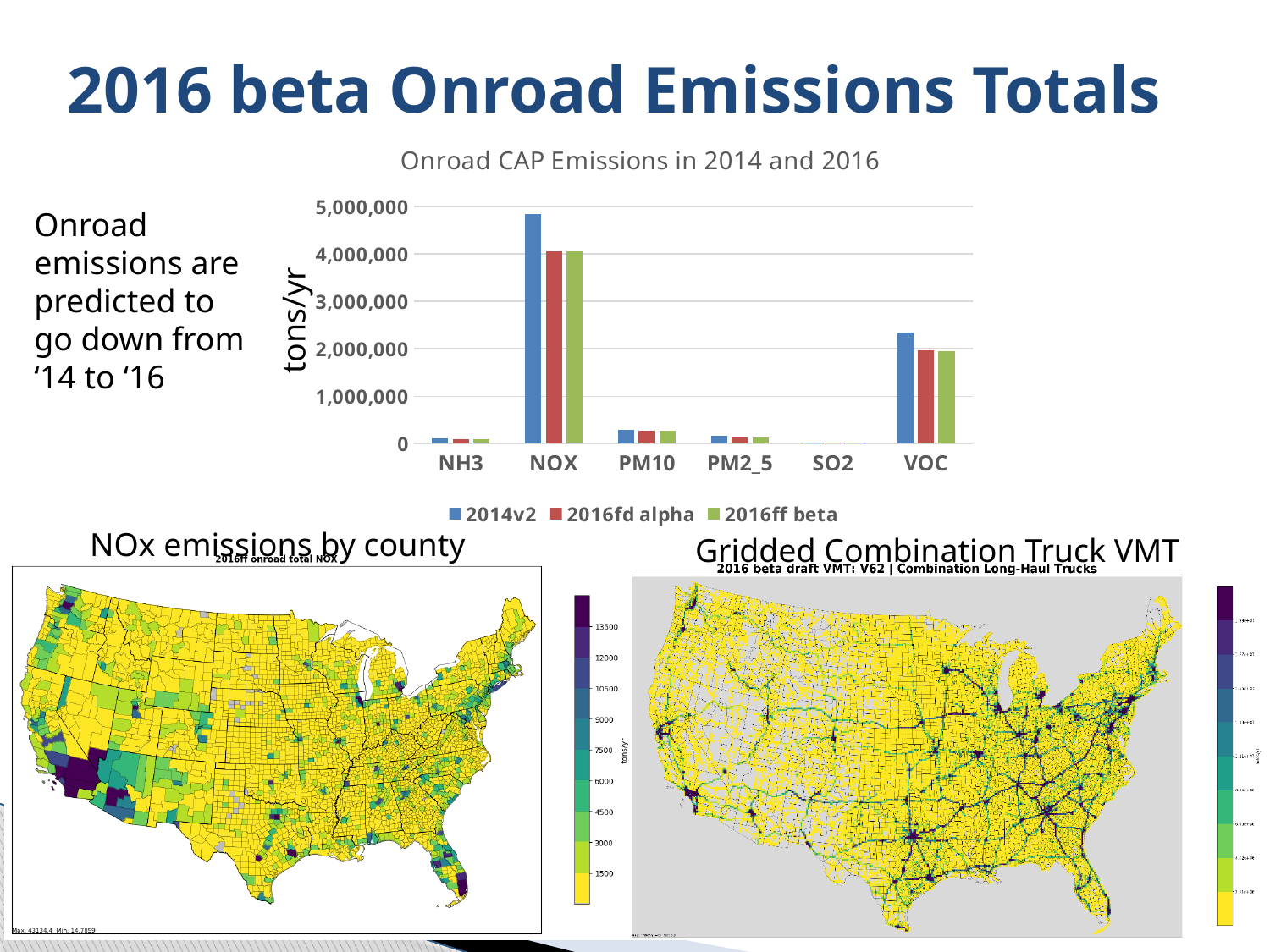
In the 'Onroad CAP Emissions in 2014 and 2016' chart, do NOX emissions rise or fall from 2014v2 to 2016ff beta? fall In the 'Onroad CAP Emissions in 2014 and 2016' chart, which pollutant has the lowest emissions? SO2 How many pollutant categories are shown on the x axis of the 'Onroad CAP Emissions in 2014 and 2016' chart? 6 In the 'Onroad CAP Emissions in 2014 and 2016' chart, is the 2014v2 value for NH3 greater or less than 1,000,000? less In the 'Onroad CAP Emissions in 2014 and 2016' chart, which is larger for NOX: the 2014v2 value or the 2016ff beta value? 2014v2 What kind of chart is 'Onroad CAP Emissions in 2014 and 2016'? bar chart In the 'Onroad CAP Emissions in 2014 and 2016' chart, is the 2014v2 value for VOC greater or less than 2,000,000? greater What are the three legend entries of the 'Onroad CAP Emissions in 2014 and 2016' chart? 2014v2, 2016fd alpha, 2016ff beta How many series does the legend of the 'Onroad CAP Emissions in 2014 and 2016' chart list? 3 In the 'Onroad CAP Emissions in 2014 and 2016' chart, which pollutant has the highest emissions? NOX In the 'Onroad CAP Emissions in 2014 and 2016' chart, is the 2014v2 value for NOX greater or less than 4,000,000? greater What is the y-axis label of the 'Onroad CAP Emissions in 2014 and 2016' chart? tons/yr